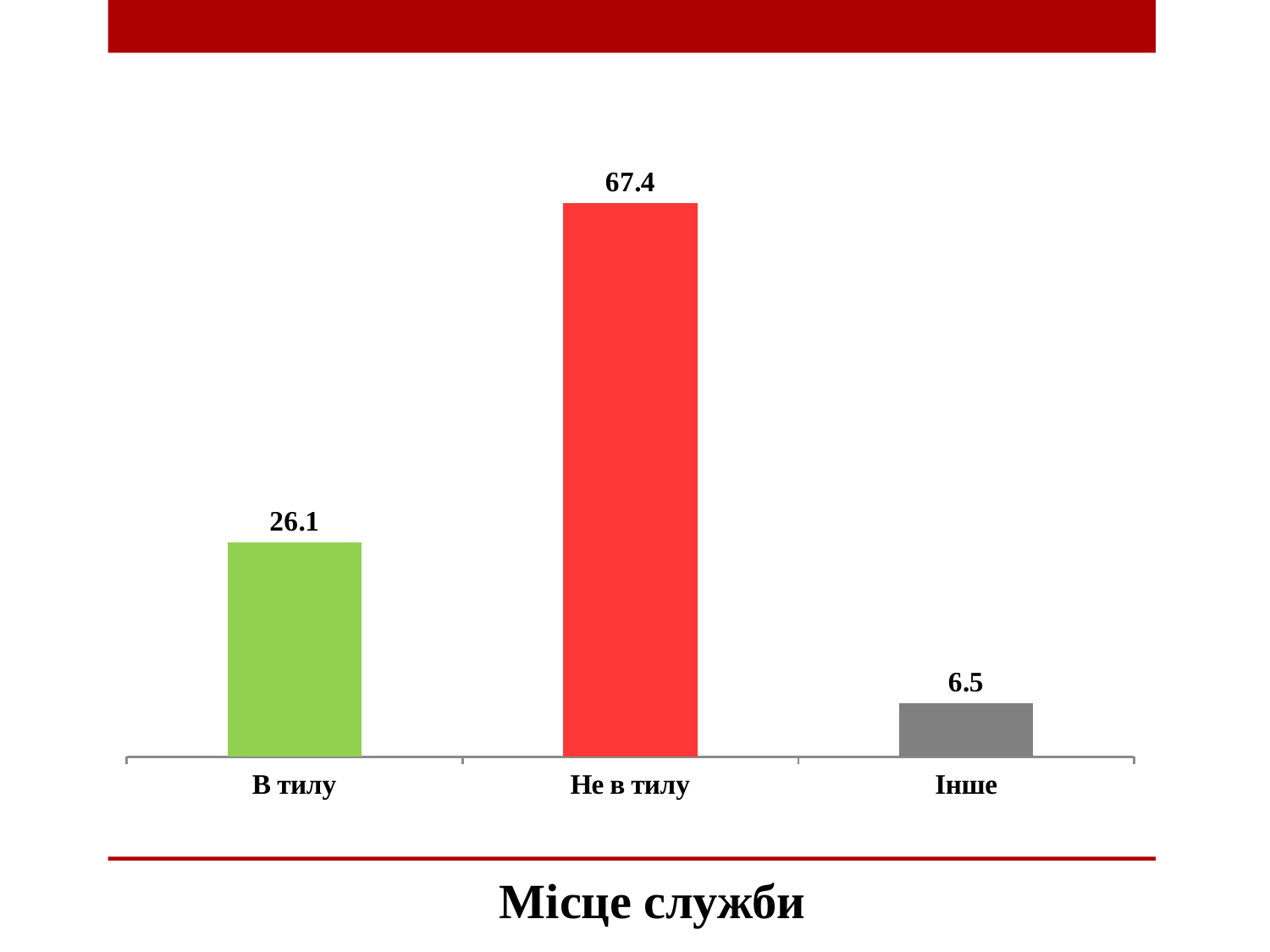
Which category has the lowest value? Інше How many categories are shown in the chart? 3 What is the title shown below the chart? Місце служби Which is larger, the value for "В тилу" or the value for "Інше"? В тилу Which category has the highest value? Не в тилу What is the difference between the values for "В тилу" and "Інше"? 19.6 What kind of chart is shown on the slide? Bar chart What is the value for "Не в тилу"? 67.4 What is the value for "В тилу"? 26.1 What is the value for "Інше"? 6.5 What is the difference between the values for "Не в тилу" and "В тилу"? 41.3 What colour is the bar for "Не в тилу"? Red